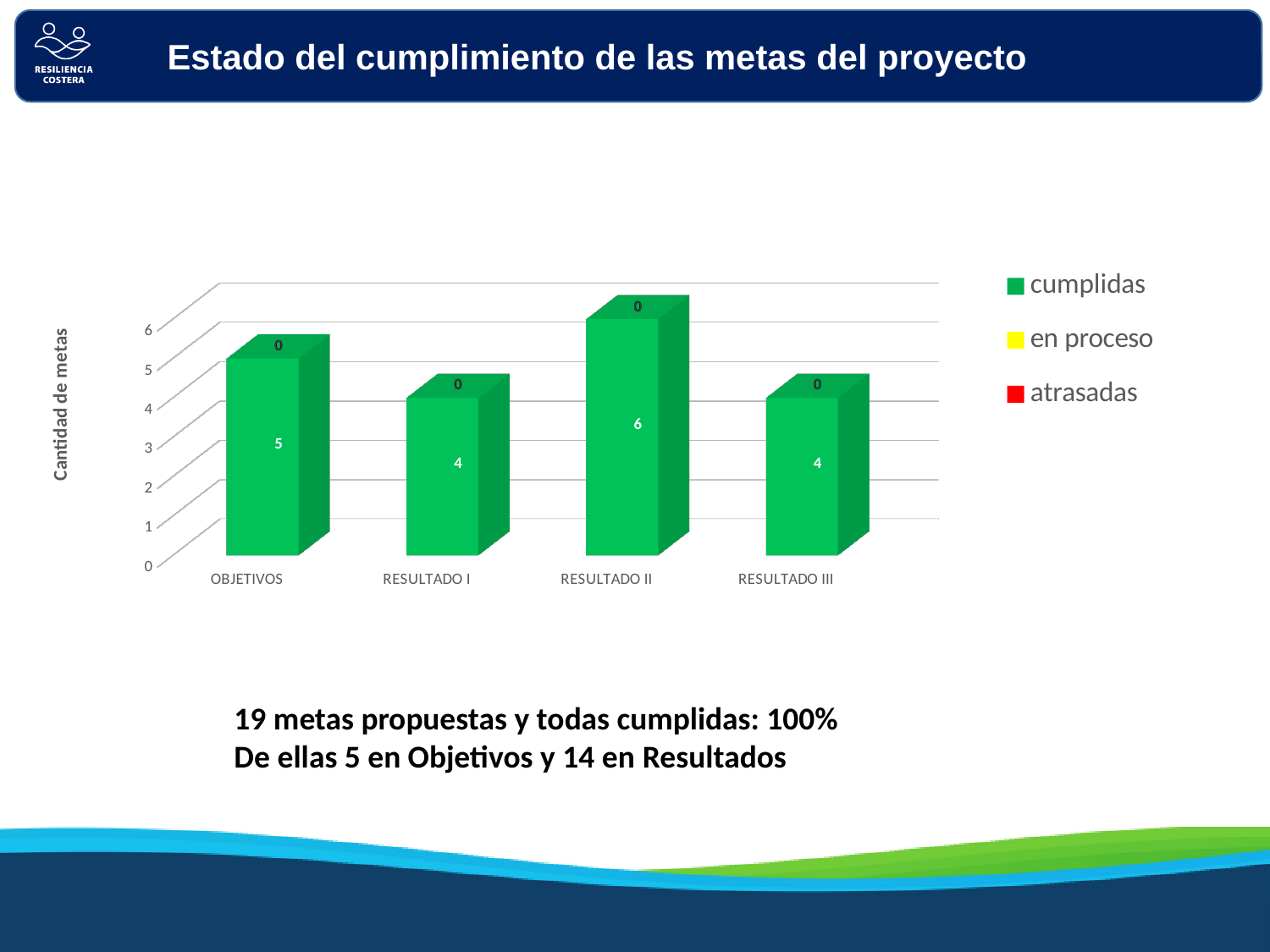
What is the difference between the cumplidas values for RESULTADO II and RESULTADO III? 2 What is the difference between the cumplidas values for OBJETIVOS and RESULTADO I? 1 What is the value of cumplidas for OBJETIVOS? 5 How many series does the legend list? 3 What is the label of the vertical axis? Cantidad de metas What is the value of cumplidas for RESULTADO I? 4 Which has more cumplidas metas, OBJETIVOS or RESULTADO I? OBJETIVOS Which colour represents the cumplidas series in the legend? green Which category has the highest number of cumplidas metas? RESULTADO II What kind of chart is shown on the slide? bar chart What is the value of cumplidas for RESULTADO II? 6 How many categories are shown on the x axis? 4